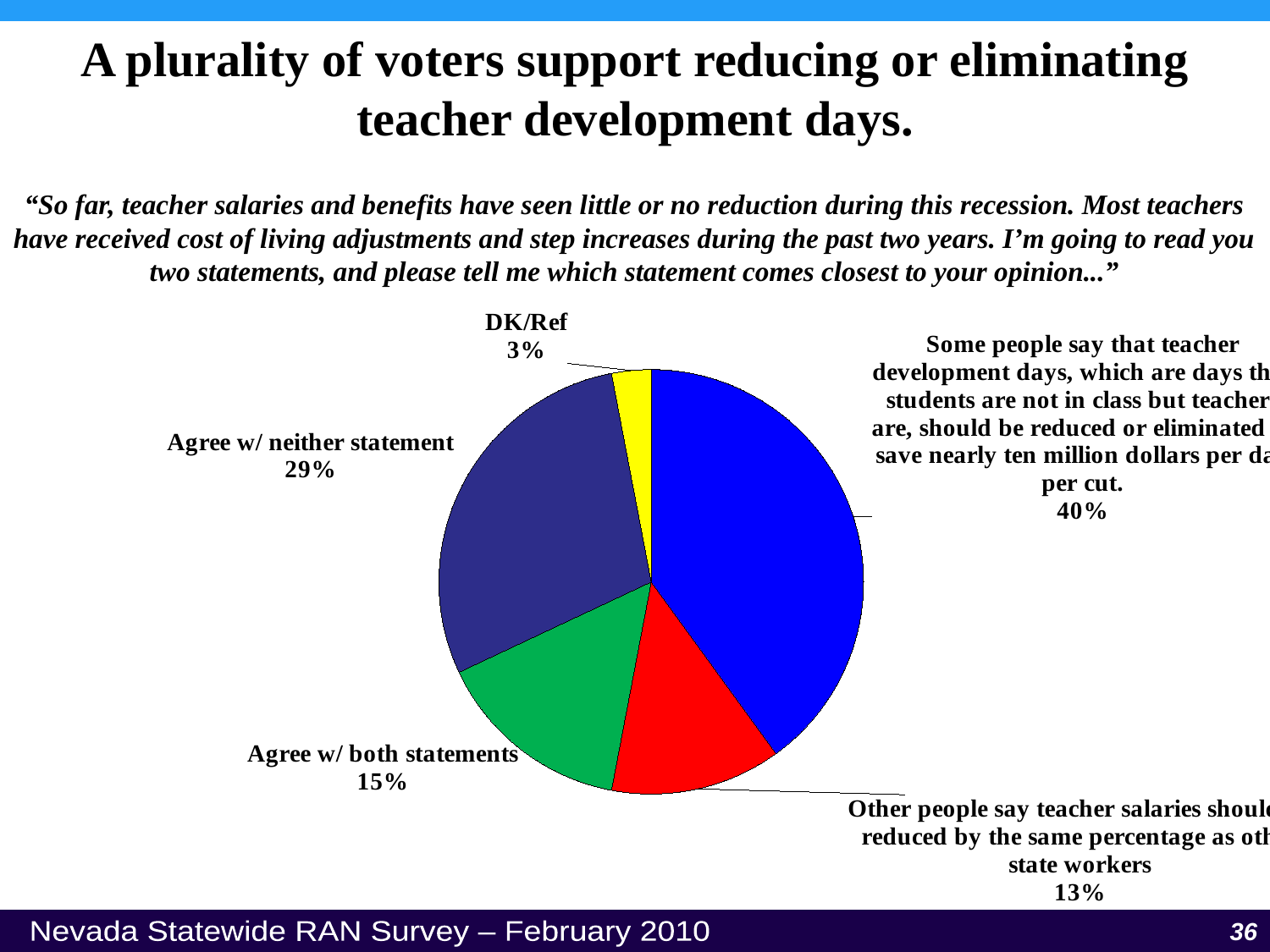
What percentage of voters say teacher salaries should be reduced by the same percentage as other state workers? 13% What percentage of voters agree with both statements? 15% What percentage of voters agree with neither statement? 29% What percentage of voters answered DK/Ref? 3% How many slices does the pie chart have? 5 What kind of chart is shown on the slide? Pie chart Which is larger: the share for 'Agree w/ both statements' or the share for reducing teacher salaries by the same percentage as other state workers? Agree w/ both statements What is the difference in percentage points between 'Agree w/ neither statement' and 'Agree w/ both statements'? 14 percentage points Which response has the smallest share of the pie? DK/Ref Which response has the largest share of the pie? Some people say that teacher development days should be reduced or eliminated (40%) What percentage of voters say teacher development days should be reduced or eliminated? 40% What colour is the slice for 'Agree w/ neither statement'? Dark blue